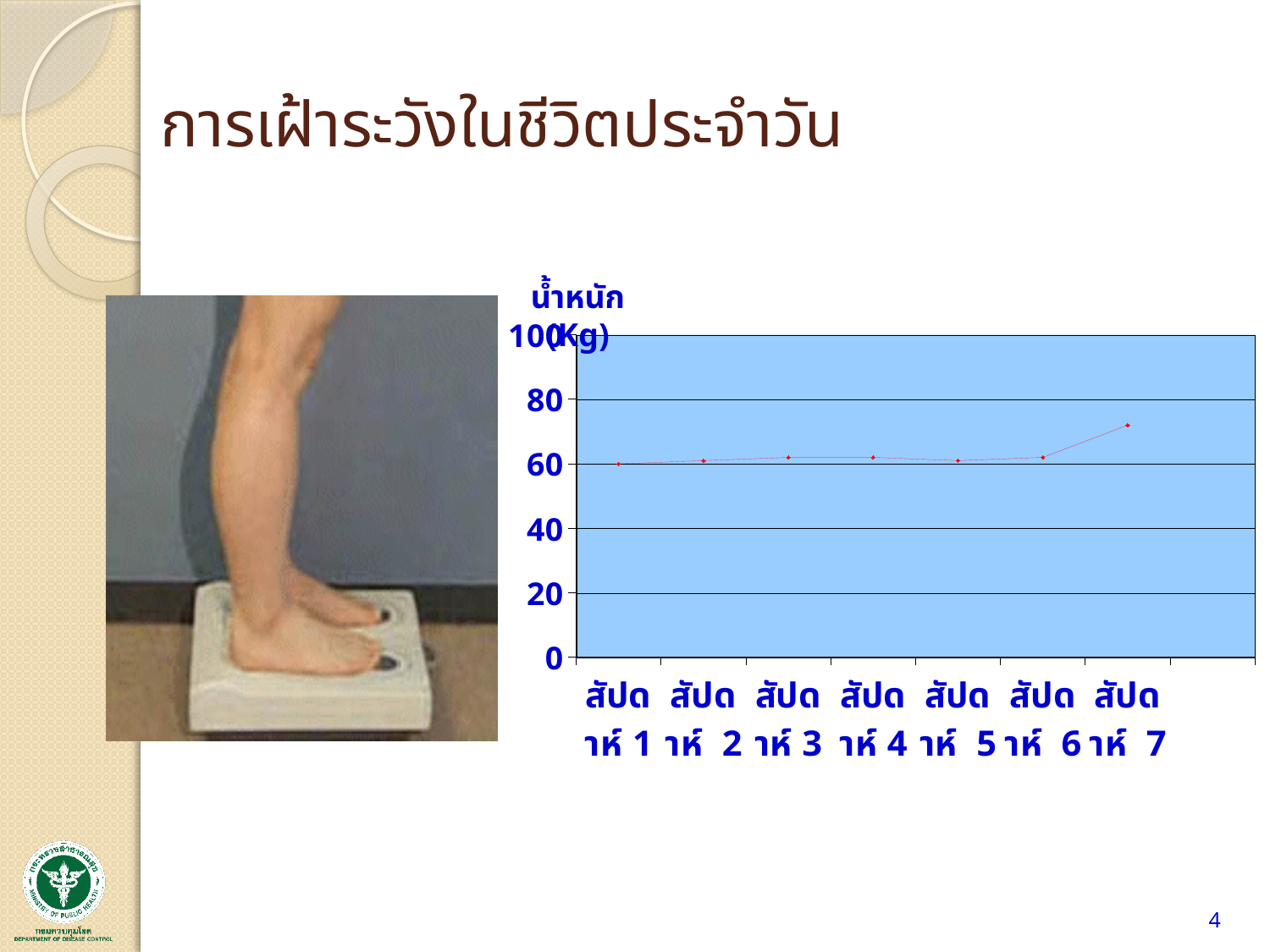
Which week has the highest weight value on the chart? สัปดาห์ 7 Is the value for สัปดาห์ 3 greater or less than 80? less What is the label of the vertical axis of the chart? น้ำหนัก (Kg) Which is larger, the value for สัปดาห์ 7 or the value for สัปดาห์ 1? สัปดาห์ 7 What is the highest value shown on the vertical axis of the chart? 100 Is the value for สัปดาห์ 5 greater or less than 40? greater Is the value for สัปดาห์ 7 greater or less than 80? less Do the values rise or fall between สัปดาห์ 6 and สัปดาห์ 7? rise What kind of chart is shown on the slide? Line chart How many data points (weeks) are plotted on the chart? 7 Which is larger, the value for สัปดาห์ 6 or the value for สัปดาห์ 7? สัปดาห์ 7